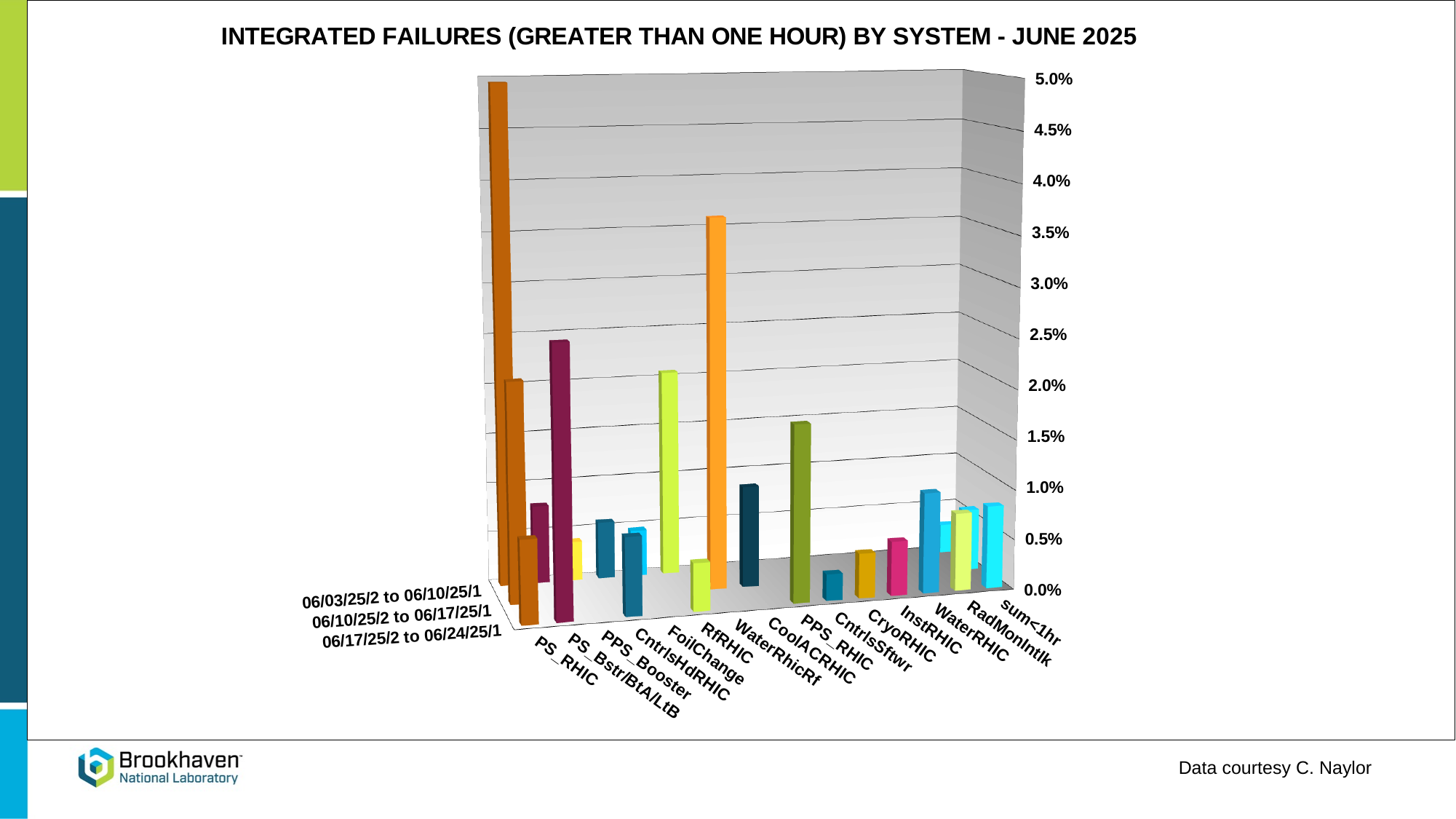
Is the tallest bar for PPS_RHIC greater or less than 0.5%? greater What is the highest value shown on the vertical axis of the chart? 5.0% Which has a taller maximum bar, CoolACRHIC or CntrlsSftwr? CoolACRHIC Is the tallest bar for PS_RHIC greater or less than 4.0%? greater Is the tallest bar for RfRHIC greater or less than 3.0%? less What is the title of the chart? INTEGRATED FAILURES (GREATER THAN ONE HOUR) BY SYSTEM - JUNE 2025 What type of chart is shown on the slide? bar chart Which has a taller maximum bar, PS_RHIC or RfRHIC? PS_RHIC Which system has the tallest bar in the chart? PS_RHIC How many system categories are shown along the x axis of the chart? 15 How many date-range series are plotted in the chart? 3